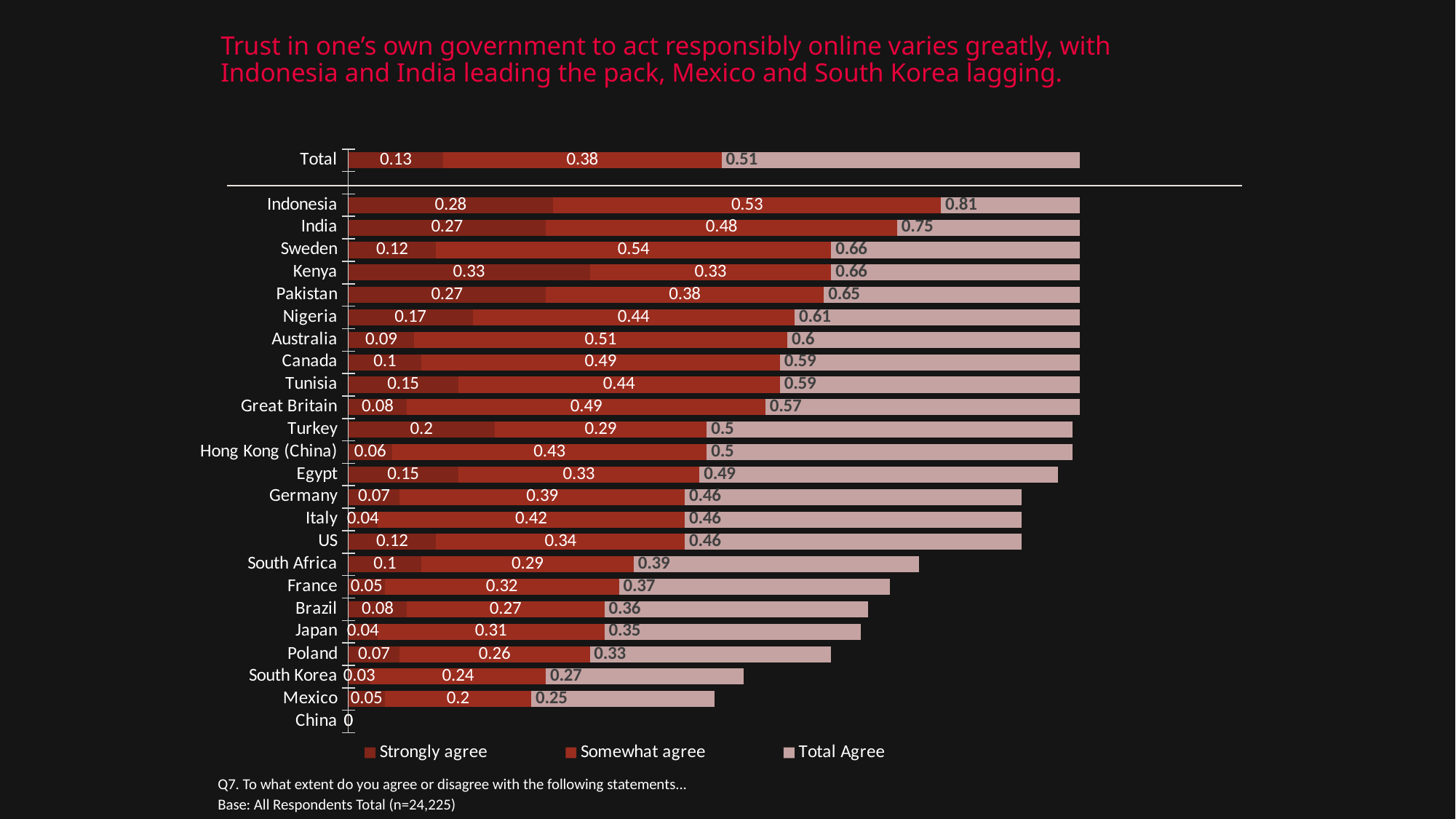
What is the Somewhat agree value for Sweden? 0.54 Which has a larger Somewhat agree value, India or Pakistan? India Which country has the highest Total Agree value? Indonesia What is the Total Agree value for China? 0 Which country has the lowest Strongly agree value among those with a non-zero bar? South Korea What kind of chart is shown on the slide? Stacked bar chart What is the difference between the Strongly agree values for Kenya and Australia? 0.24 What is the Strongly agree value for Kenya? 0.33 What is the difference between the Total Agree values for Indonesia and Mexico? 0.56 What is the Total Agree value for Indonesia? 0.81 How many series does the legend list? 3 What is the Total Agree value for the Total row? 0.51